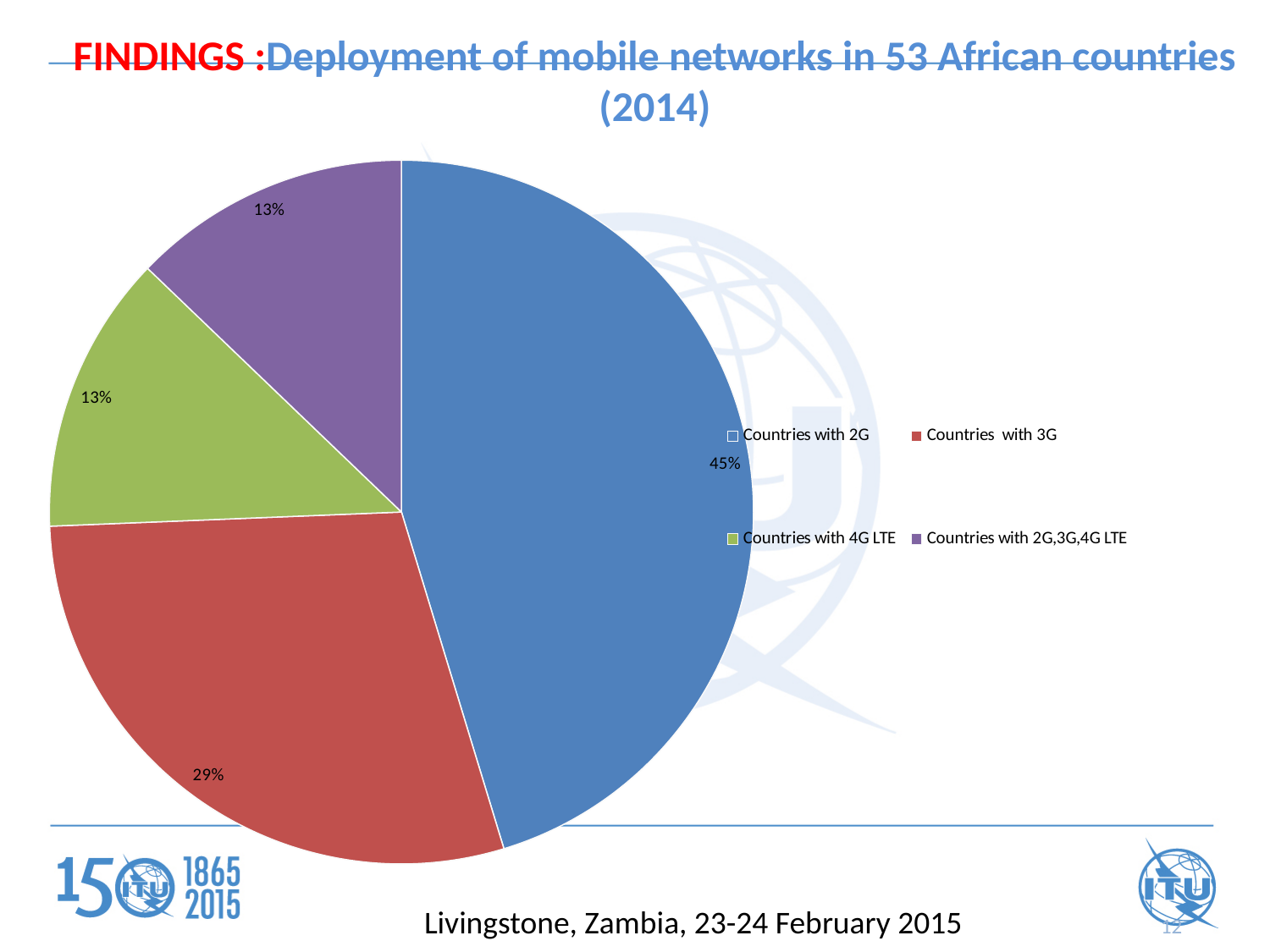
How many slices does the pie chart have? 4 What colour is the slice for Countries with 4G LTE? Green Which is larger, the slice for Countries with 3G or the slice for Countries with 4G LTE? Countries with 3G What share of the pie is labelled for Countries with 2G? 45% What share of the pie is labelled for Countries with 3G? 29% Which category has the largest slice of the pie? Countries with 2G What share of the pie is labelled for Countries with 4G LTE? 13% What is the difference in percentage points between the Countries with 2G slice and the Countries with 3G slice? 16 How many entries does the legend list? 4 What is the title of the chart on the slide? Deployment of mobile networks in 53 African countries (2014) What kind of chart is shown on the slide? Pie chart